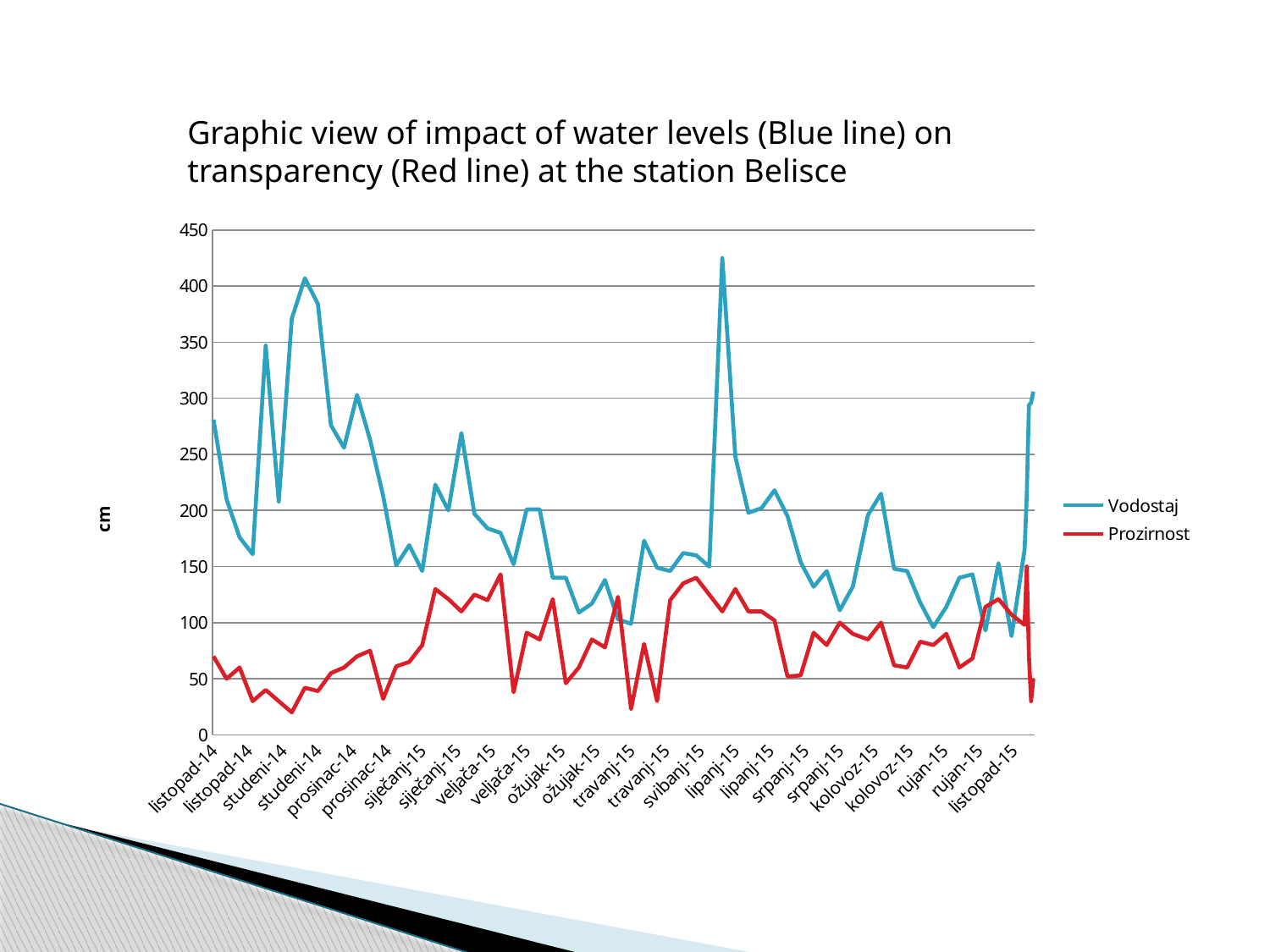
What kind of chart is shown on the slide? line chart Does the Vodostaj line rise or fall from its peak in lipanj-15 to srpanj-15? fall Is the first Vodostaj value at listopad-14 greater or less than 250? greater Is the peak value of Vodostaj around lipanj-15 greater or less than 400? greater Which series reaches the highest value on the chart, Vodostaj or Prozirnost? Vodostaj What unit is shown on the y axis label? cm Is the lowest value of Prozirnost around studeni-14 greater or less than 50? less At the peak around lipanj-15, which series has the larger value, Vodostaj or Prozirnost? Vodostaj How many series does the legend list? 2 What colour is the Prozirnost line? red Which series reaches the lowest value on the chart, Vodostaj or Prozirnost? Prozirnost